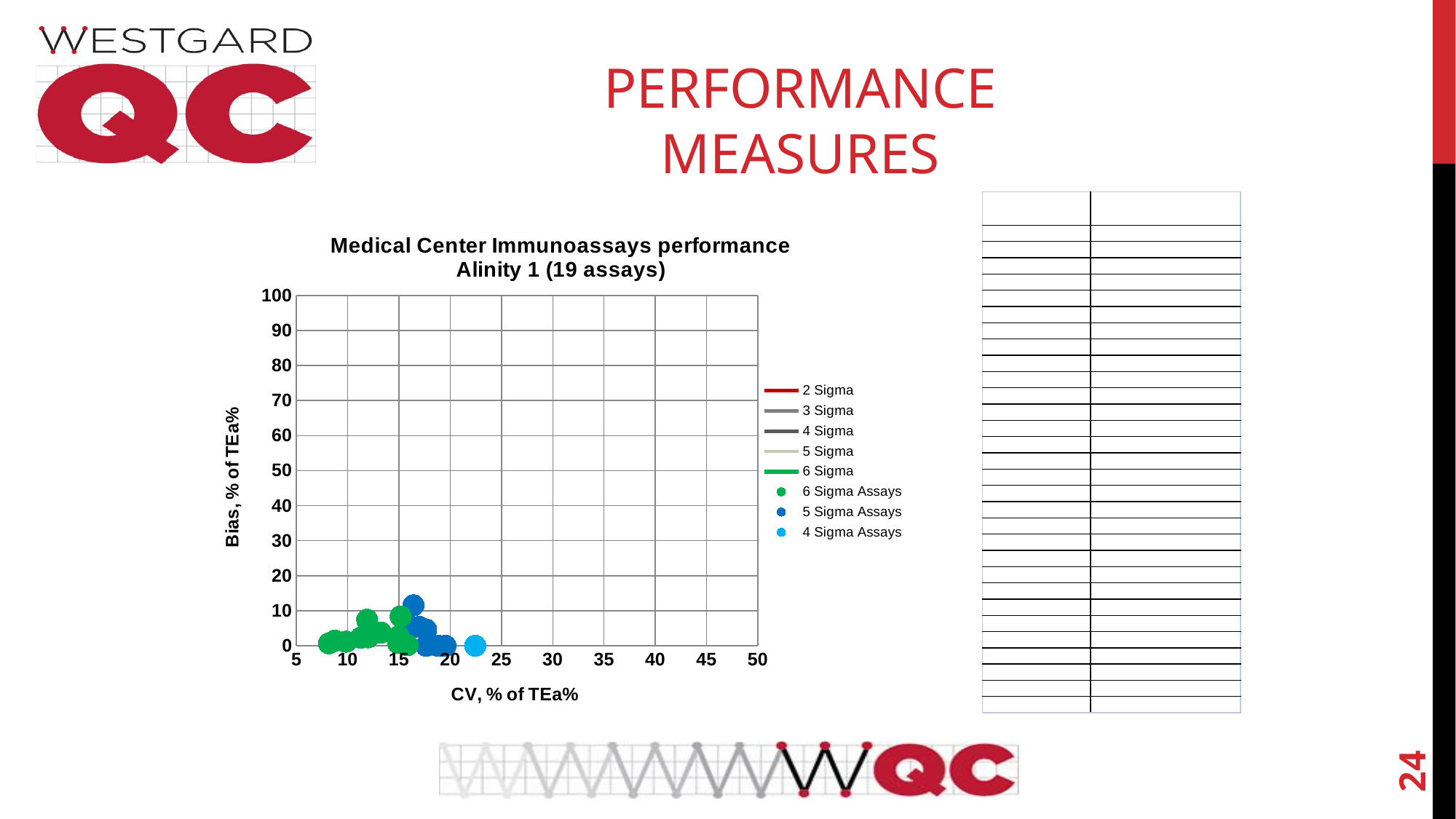
How many assays does the chart title say are plotted? 19 What is the lowest value shown on the x axis? 5 Are the CV values of the 6 Sigma Assays points greater or less than 20? less How many 4 Sigma Assays points are plotted on the chart? 1 What is the highest value shown on the y axis? 100 What is the title of the chart? Medical Center Immunoassays performance Alinity 1 (19 assays) How many entries does the chart legend list? 8 What is the label of the x axis? CV, % of TEa% Is the CV value for the 4 Sigma Assays point greater or less than 20? greater Is the CV value for the 4 Sigma Assays point greater or less than 25? less What kind of chart is shown on the slide? scatter chart